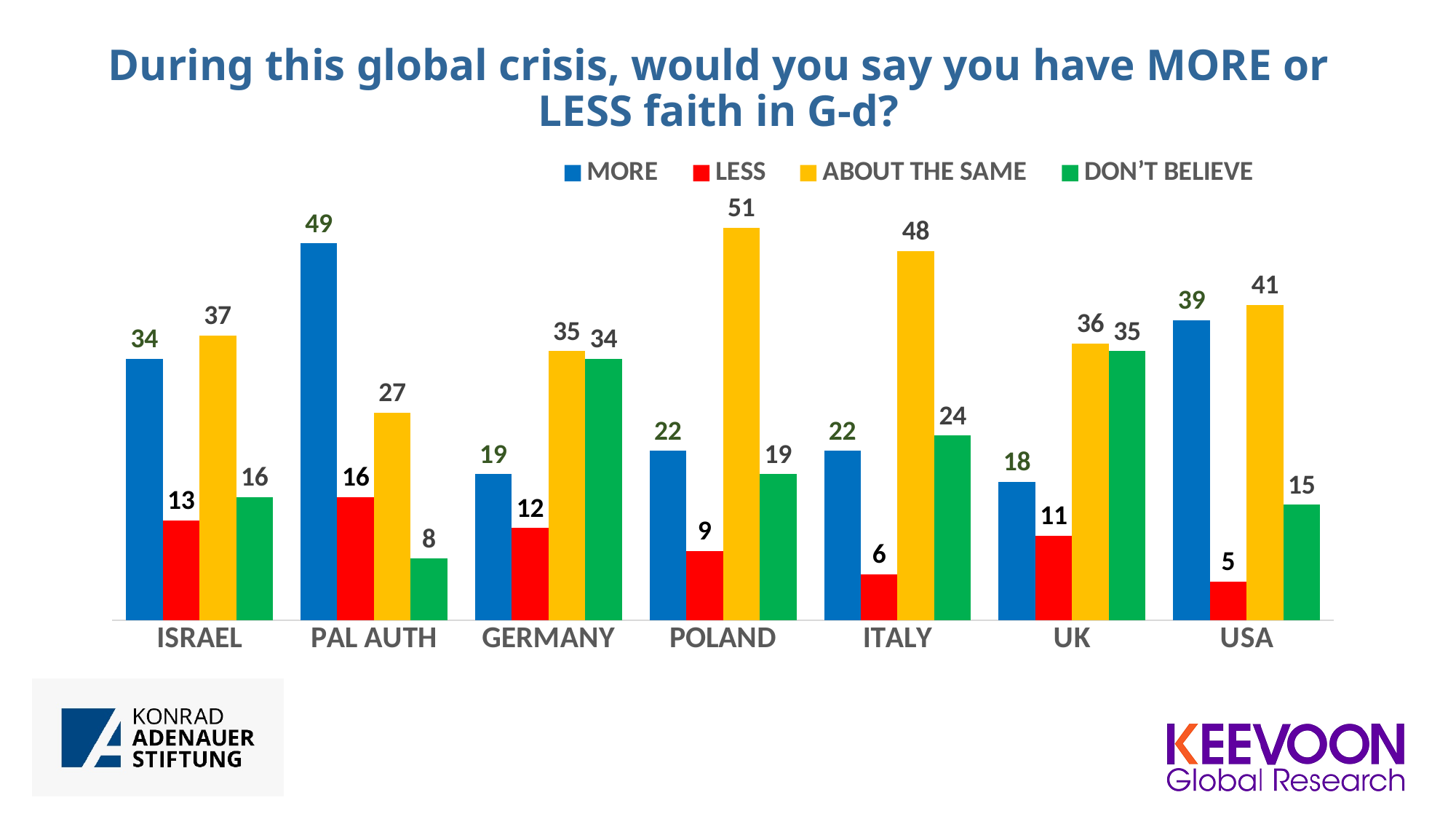
Which colour represents the LESS series? Red What is the value for DON'T BELIEVE in Germany? 34 Which is larger in the UK: ABOUT THE SAME or DON'T BELIEVE? ABOUT THE SAME Which country has the highest value for MORE? PAL AUTH Which country has the lowest value for LESS? USA How many series does the legend list? 4 What is the value for ABOUT THE SAME in Poland? 51 What is the difference between ABOUT THE SAME and MORE in Italy? 26 What is the value for MORE in Israel? 34 What is the value for LESS in the USA? 5 How many countries are shown on the x axis? 7 What kind of chart is shown on the slide? Bar chart